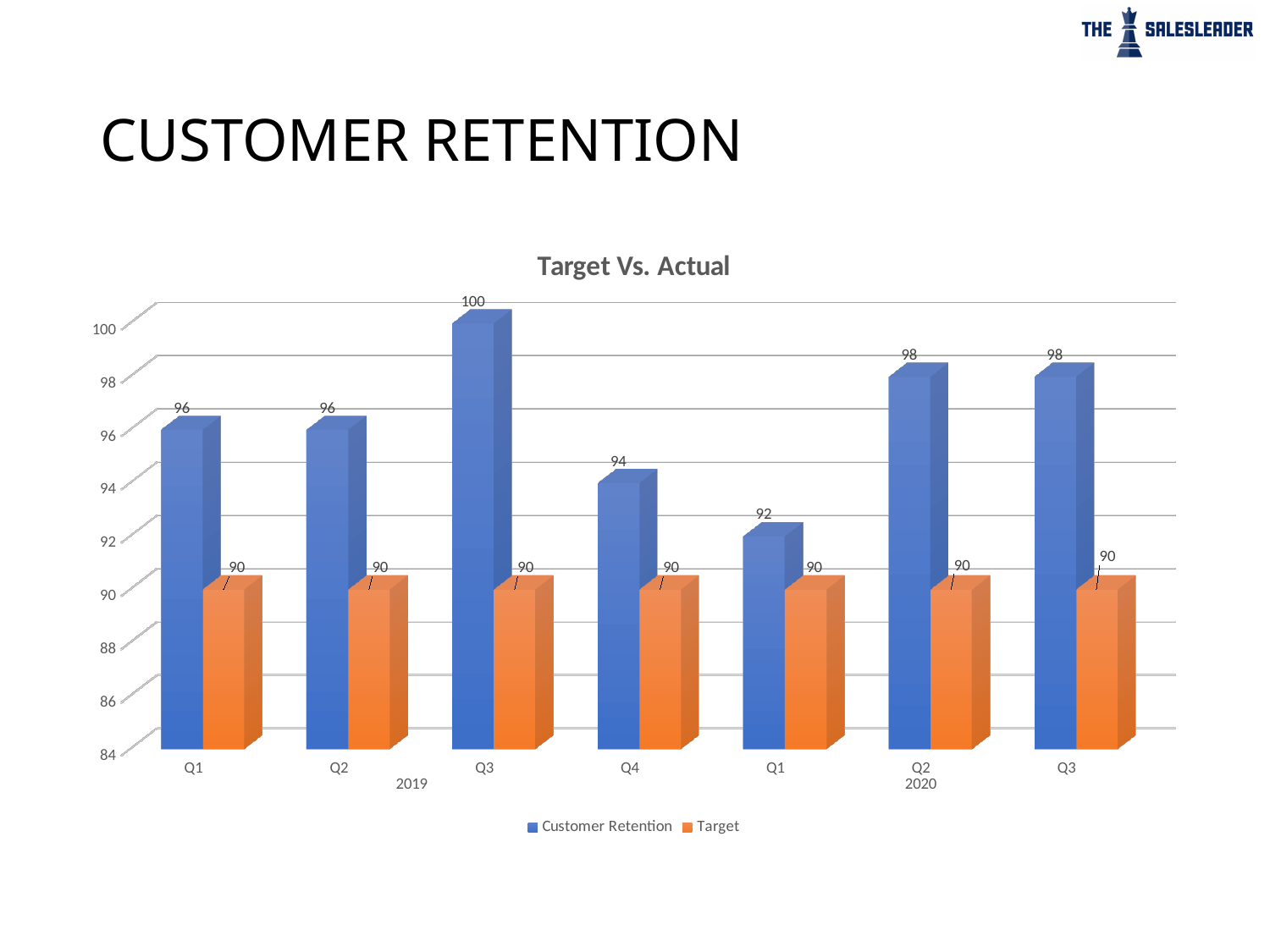
What is the Customer Retention value for Q1 2020? 92 What is the Target value for Q4 2019? 90 What is the Customer Retention value for Q3 2019? 100 Which is larger, Customer Retention in Q1 2019 or in Q4 2019? Q1 2019 What kind of chart is shown? Bar chart Which quarter has the lowest Customer Retention value? Q1 2020 Which quarter has the highest Customer Retention value? Q3 2019 What is the difference between Customer Retention in Q2 2020 and Q4 2019? 4 What is the title of the chart? Target Vs. Actual What is the difference between Customer Retention and Target in Q3 2019? 10 How many quarters are shown on the x axis? 7 How many series does the legend list? 2